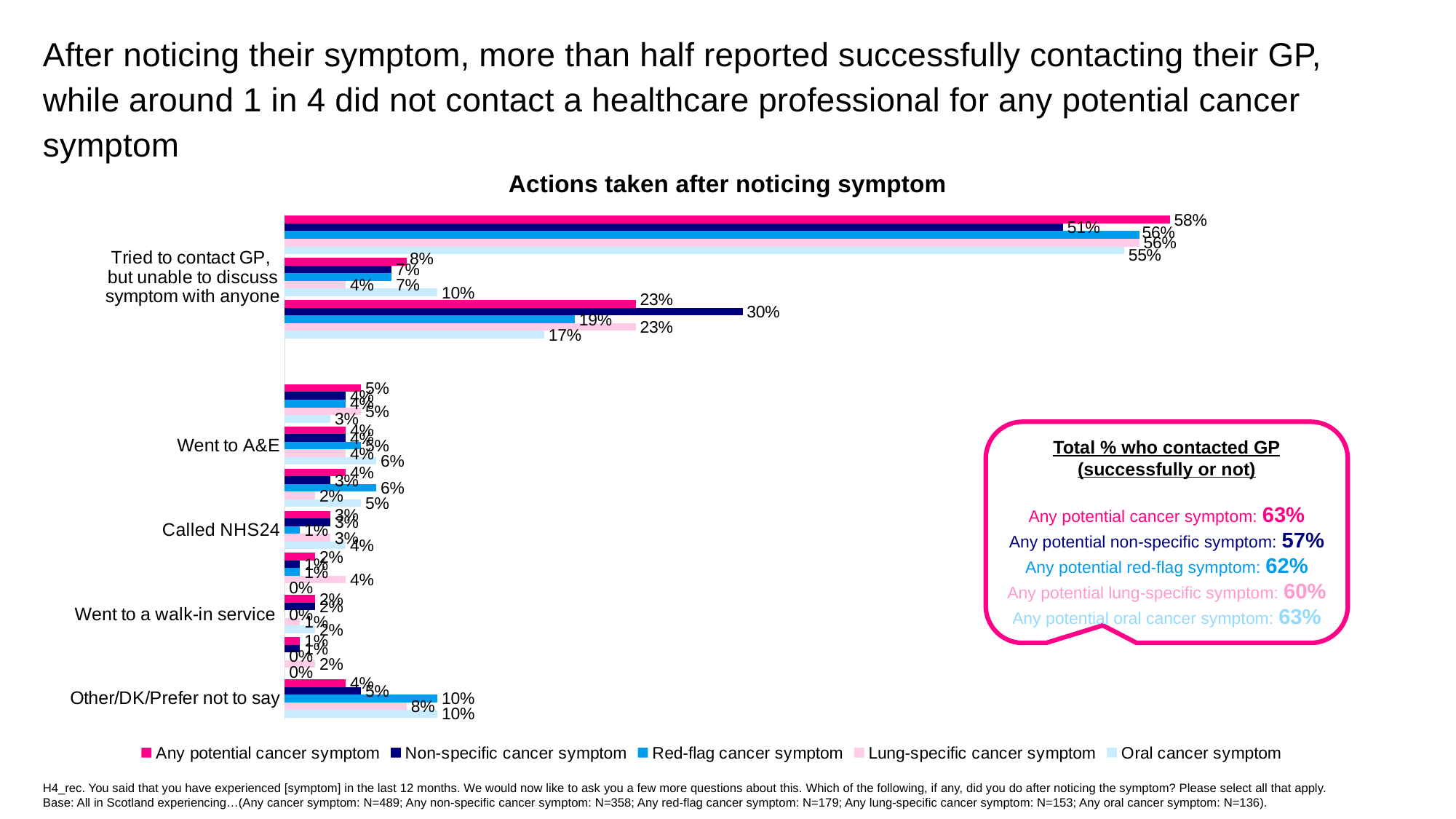
In the topmost group of bars, what is the value for Oral cancer symptom? 55% How many series does the chart legend list? 5 Which series does the bar labelled 30% belong to? Non-specific cancer symptom What is the title of the chart? Actions taken after noticing symptom In the topmost group of bars, what is the value for Non-specific cancer symptom? 51% For Other/DK/Prefer not to say, what is the value for Red-flag cancer symptom? 10% What is the highest value labelled anywhere on the chart? 58% What type of chart is shown on the slide? Bar chart For Other/DK/Prefer not to say, what is the value for Lung-specific cancer symptom? 8% In the topmost group of bars, what is the difference between the Any potential cancer symptom value (58%) and the Non-specific cancer symptom value (51%)? 7 percentage points For Other/DK/Prefer not to say, which is larger: the Any potential cancer symptom value or the Oral cancer symptom value? Oral cancer symptom In the topmost group of bars, which series has the highest value? Any potential cancer symptom